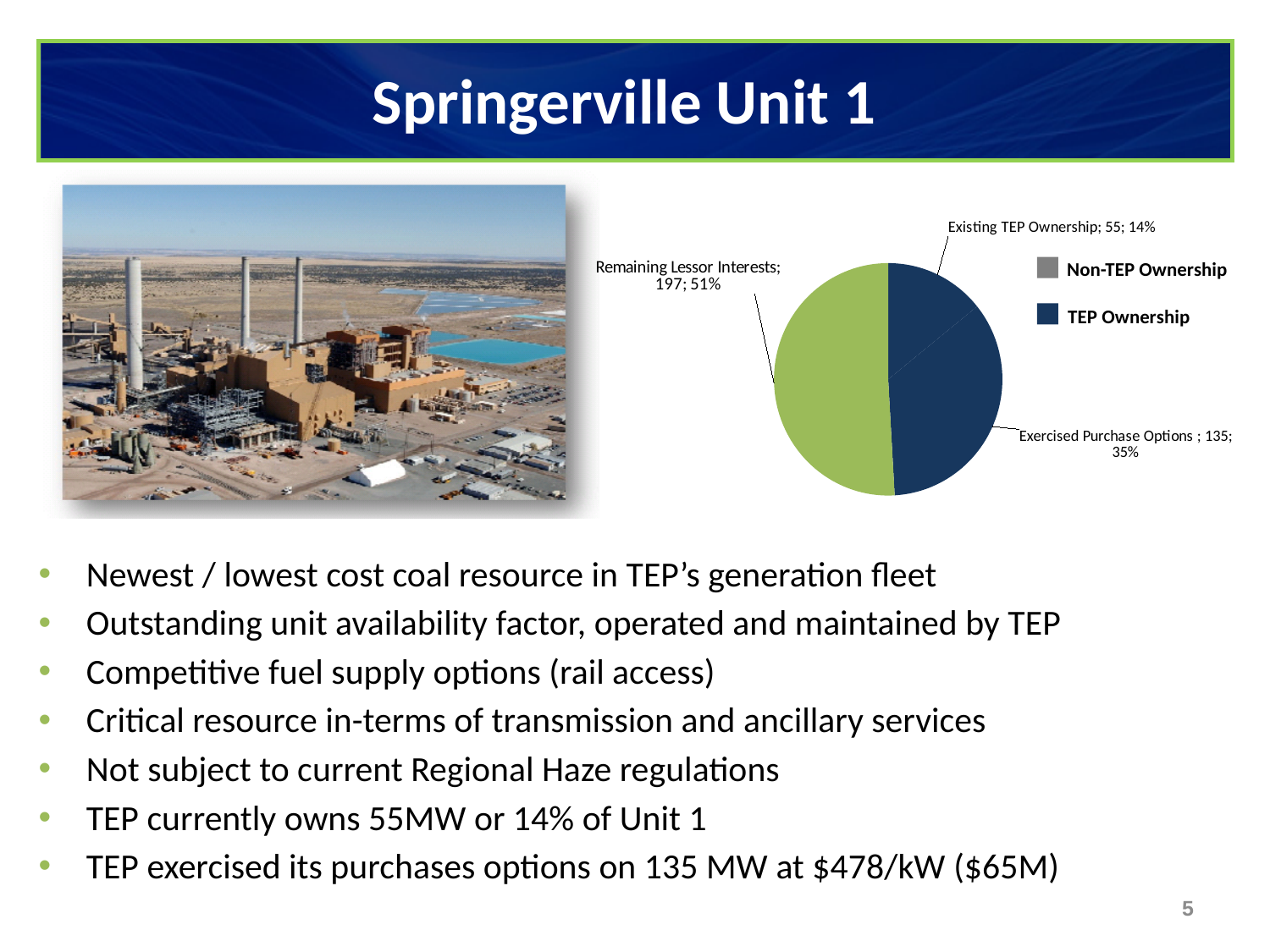
What kind of chart is shown on the slide? pie chart Which slice of the pie chart is the smallest? Existing TEP Ownership What value is shown for Remaining Lessor Interests in the pie chart? 197 What share of the pie does Remaining Lessor Interests represent? 51% Which legend entry in the pie chart is shown in dark blue? TEP Ownership What share of the pie does Exercised Purchase Options represent? 35% What value is shown for Existing TEP Ownership in the pie chart? 55 What value is shown for Exercised Purchase Options in the pie chart? 135 How many slices does the pie chart have? 3 What is the difference between the values for Remaining Lessor Interests and Exercised Purchase Options? 62 Which slice of the pie chart is the largest? Remaining Lessor Interests How many entries does the legend of the pie chart list? 2